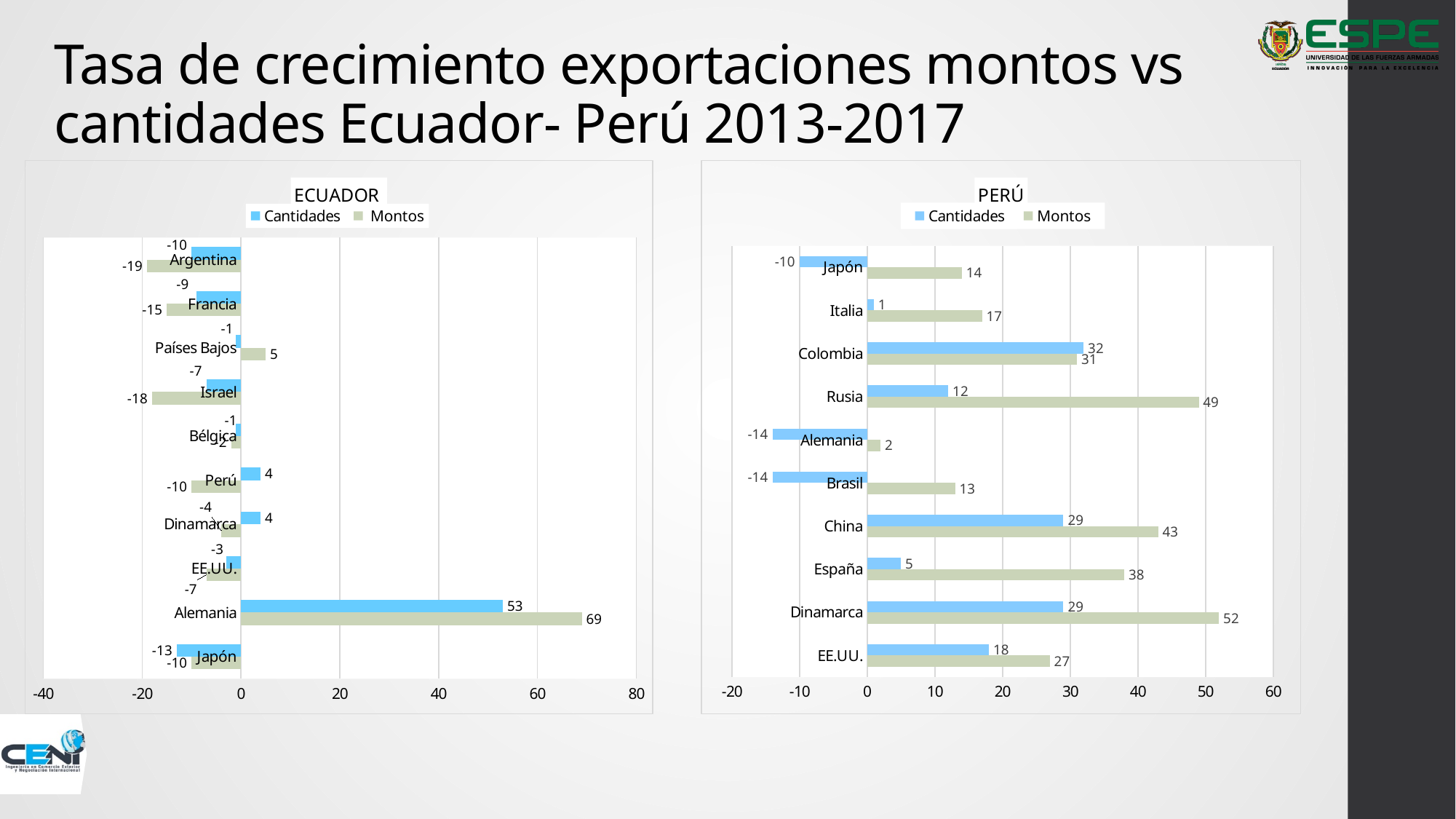
In the PERÚ chart, what is the Montos value for Rusia? 49 In the ECUADOR chart, which country has the highest Cantidades value? Alemania In the PERÚ chart, what is the difference between the Montos values for Dinamarca and EE.UU.? 25 In the ECUADOR chart, what is the Montos value for Alemania? 69 In the ECUADOR chart, which country has the lowest Montos value? Argentina How many countries are shown in the PERÚ chart? 10 In the ECUADOR chart, what is the difference between the Montos and Cantidades values for Alemania? 16 How many series does the legend of the ECUADOR chart list? 2 In the PERÚ chart, which country has the highest Montos value? Dinamarca In the ECUADOR chart, what is the Cantidades value for Argentina? -10 In the PERÚ chart, which country has the highest Cantidades value? Colombia In the PERÚ chart, which is larger for China: Cantidades or Montos? Montos